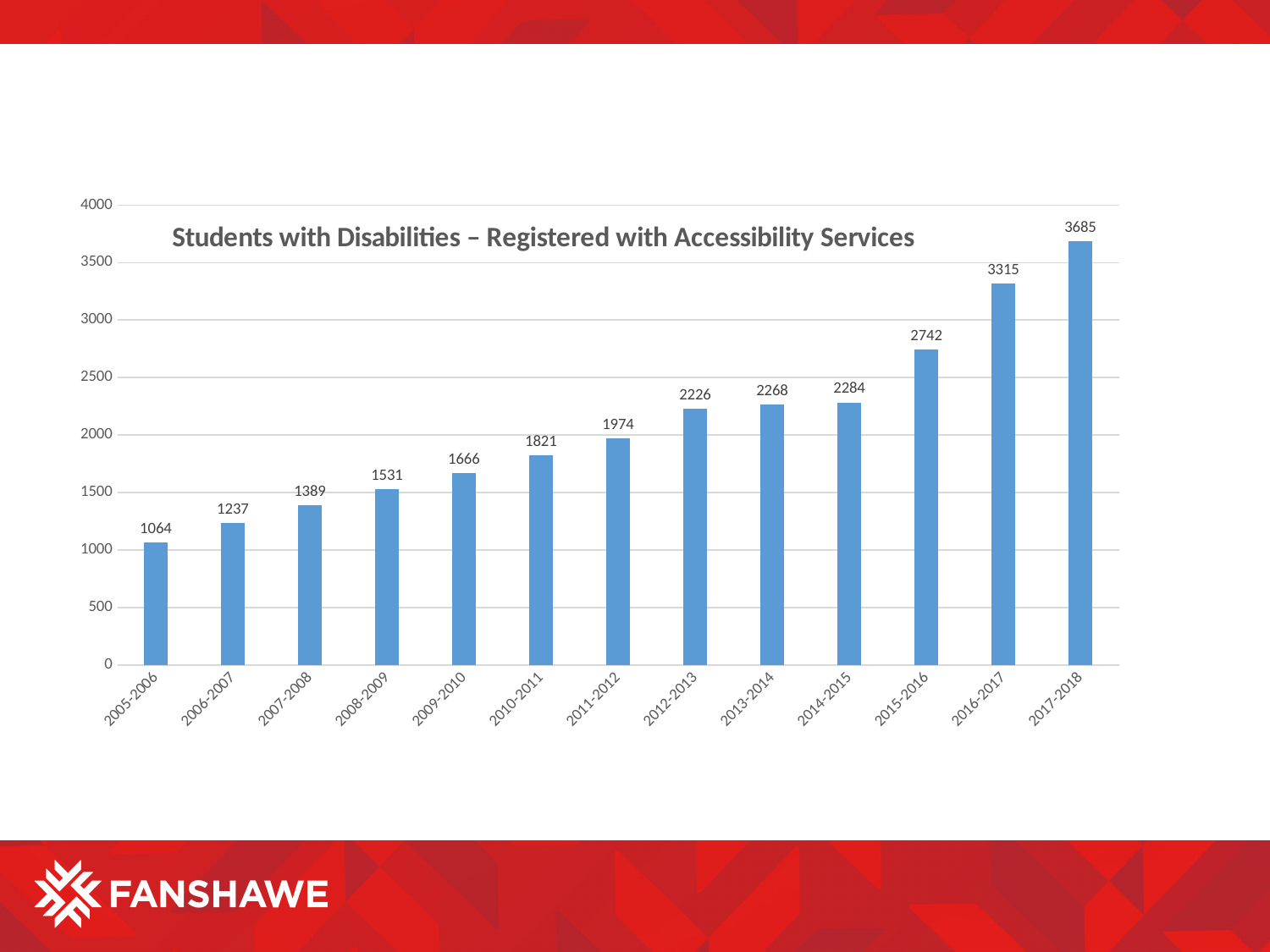
Do the values rise or fall from 2005-2006 to 2017-2018? Rise Which year has the highest value? 2017-2018 What kind of chart is shown on the slide? Bar chart What is the difference between the values for 2017-2018 and 2016-2017? 370 Is the value for 2011-2012 greater or less than 2000? less What is the difference between the values for 2015-2016 and 2014-2015? 458 Which year has the lowest value? 2005-2006 How many years are shown on the x axis? 13 Which is larger, the value for 2009-2010 or the value for 2010-2011? 2010-2011 What is the value for 2012-2013? 2226 What is the value for 2005-2006? 1064 What is the value for 2016-2017? 3315